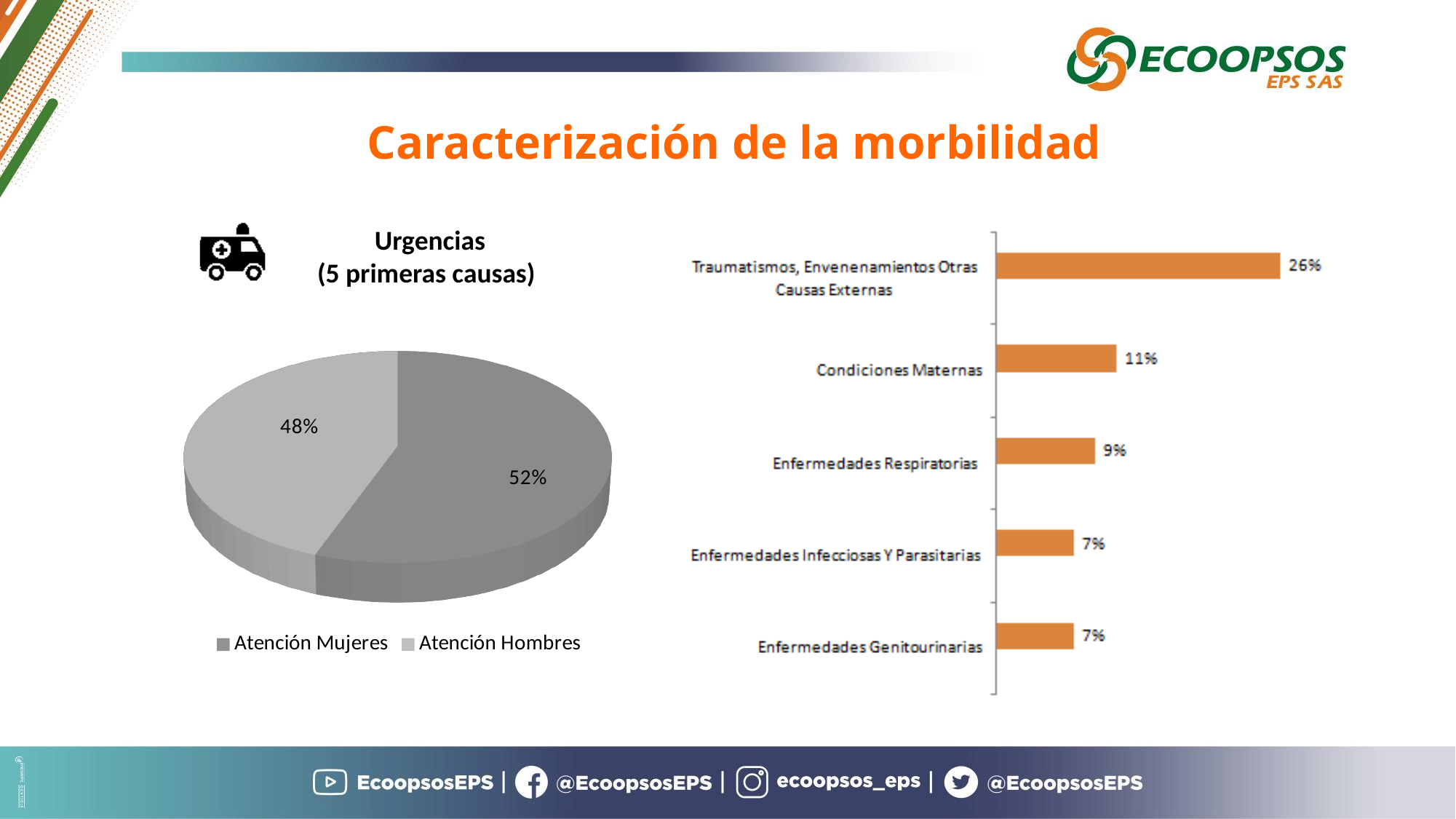
In the bar chart on the right, what is the value for Condiciones Maternas? 11% In the pie chart on the left, what share is labelled for Atención Mujeres? 52% In the bar chart on the right, what is the difference between the values for Traumatismos, Envenenamientos Otras Causas Externas and Condiciones Maternas? 15% In the pie chart on the left, which slice is larger, Atención Mujeres or Atención Hombres? Atención Mujeres In the pie chart on the left, how many entries does the legend list? 2 In the bar chart on the right, how many categories are shown? 5 What kind of chart is the chart on the right of the slide? Bar chart In the bar chart on the right, which is larger, the value for Enfermedades Respiratorias or Enfermedades Genitourinarias? Enfermedades Respiratorias In the pie chart on the left, what share is labelled for Atención Hombres? 48% In the bar chart on the right, what is the value for Enfermedades Respiratorias? 9% In the bar chart on the right, which category has the highest value? Traumatismos, Envenenamientos Otras Causas Externas What kind of chart is the chart on the left of the slide? Pie chart